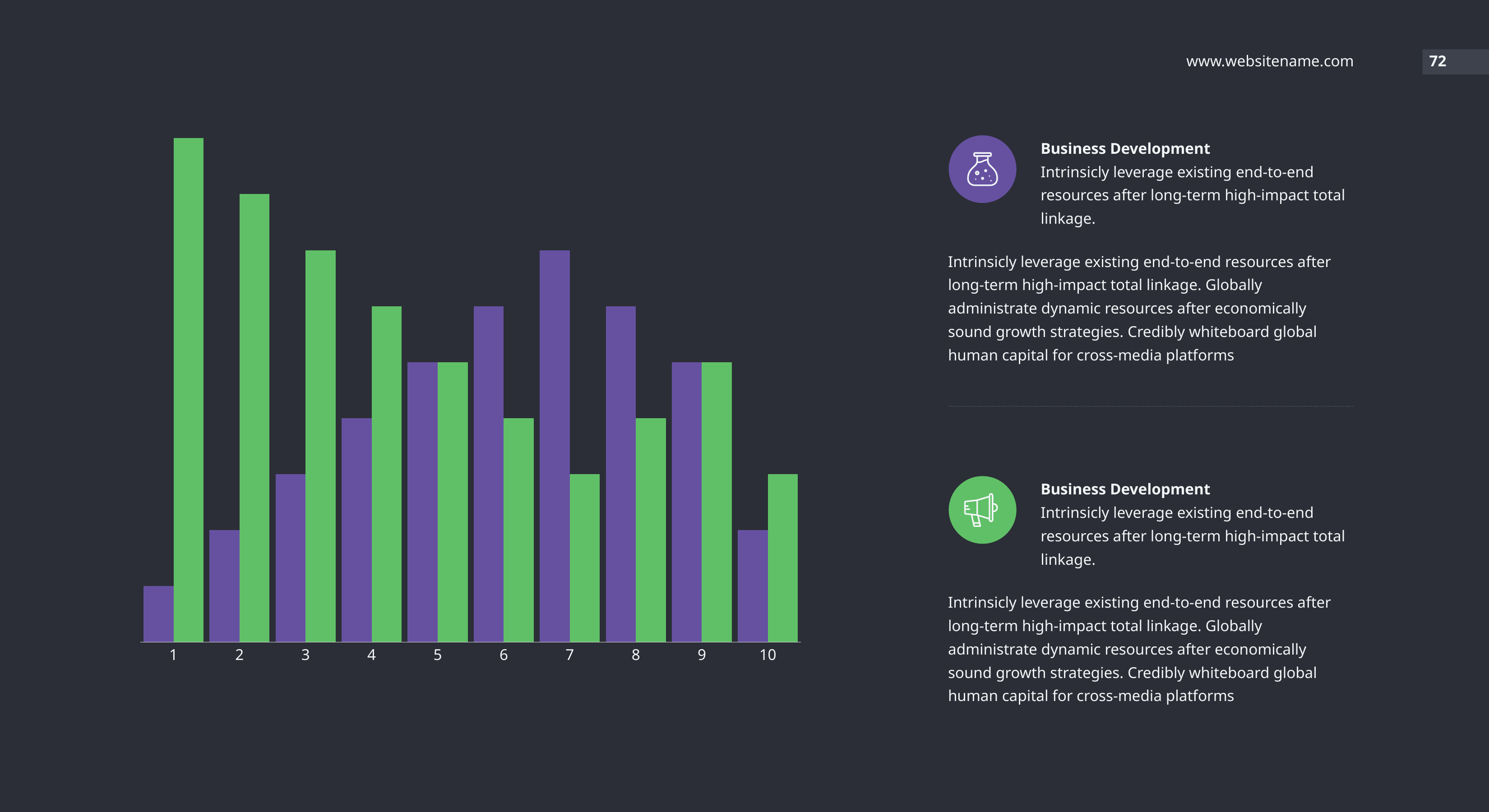
How many bar series are plotted in the chart? 2 What kind of chart is shown on the slide? bar chart Do the purple bars rise or fall from category 1 to category 7? rise How many categories are shown on the x axis of the chart? 10 At category 7, which bar is taller, the purple one or the green one? purple Which category has the tallest green bar? 1 At category 1, which bar is taller, the purple one or the green one? green Which category has the shortest purple bar? 1 What two colours are used for the bars in the chart? purple and green Do the green bars rise or fall from category 1 to category 4? fall Which category has the tallest purple bar? 7 Which is taller, the green bar at category 2 or the green bar at category 3? category 2